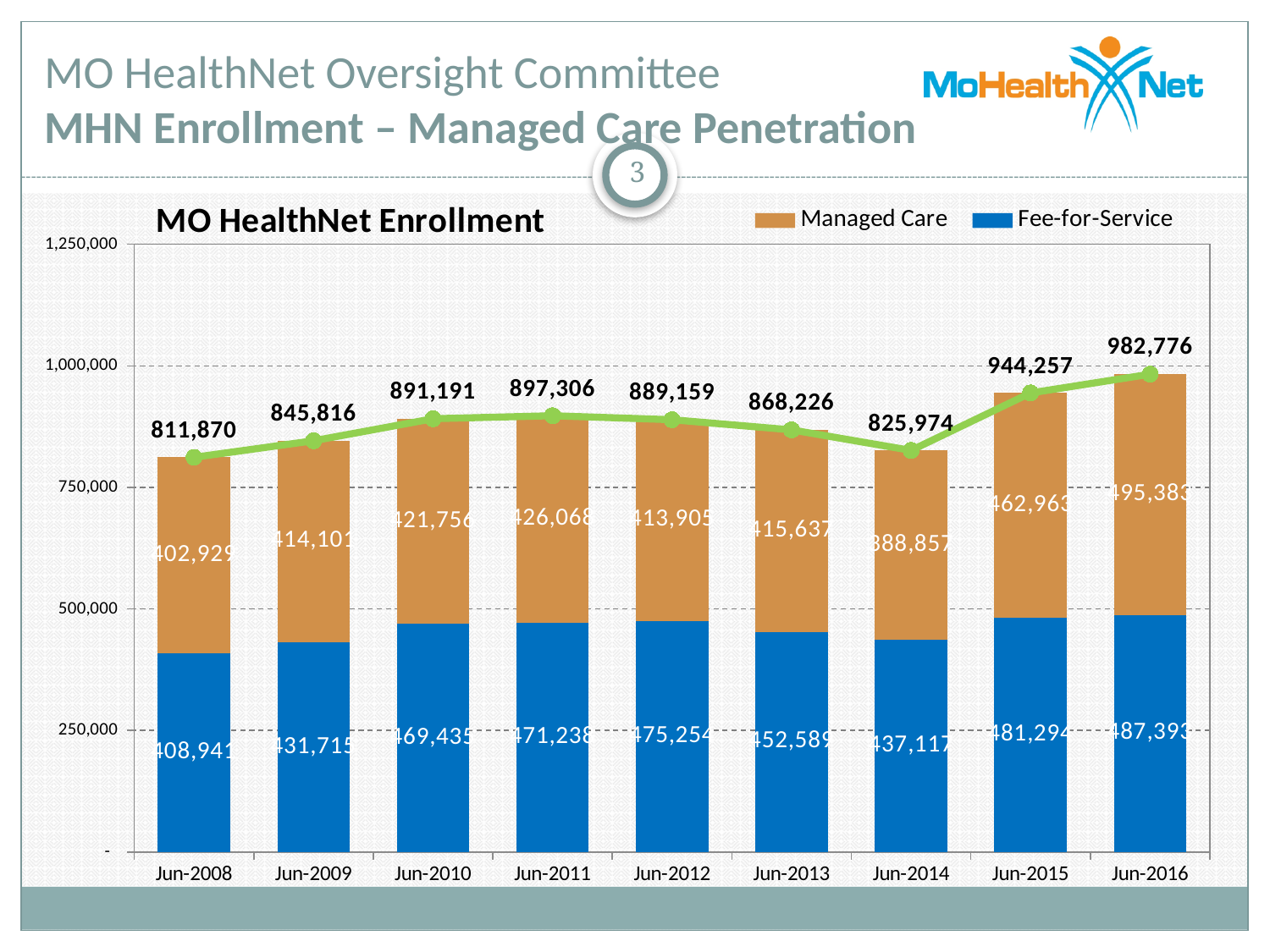
What is the total enrollment shown for Jun-2016? 982,776 In Jun-2010, which is larger: Managed Care or Fee-for-Service enrollment? Fee-for-Service How many time periods are shown on the x axis? 9 What is the Managed Care enrollment for Jun-2014? 388,857 Does total enrollment rise or fall from Jun-2014 to Jun-2016? Rise How many series does the legend list? 2 Which period has the highest total enrollment? Jun-2016 What is the title of the chart? MO HealthNet Enrollment What kind of chart is used to show the enrollment data? Stacked bar chart with a line overlay showing total enrollment How much higher is Fee-for-Service enrollment in Jun-2016 than in Jun-2015? 6,099 Which period has the lowest total enrollment? Jun-2008 What is the Fee-for-Service enrollment for Jun-2012? 475,254